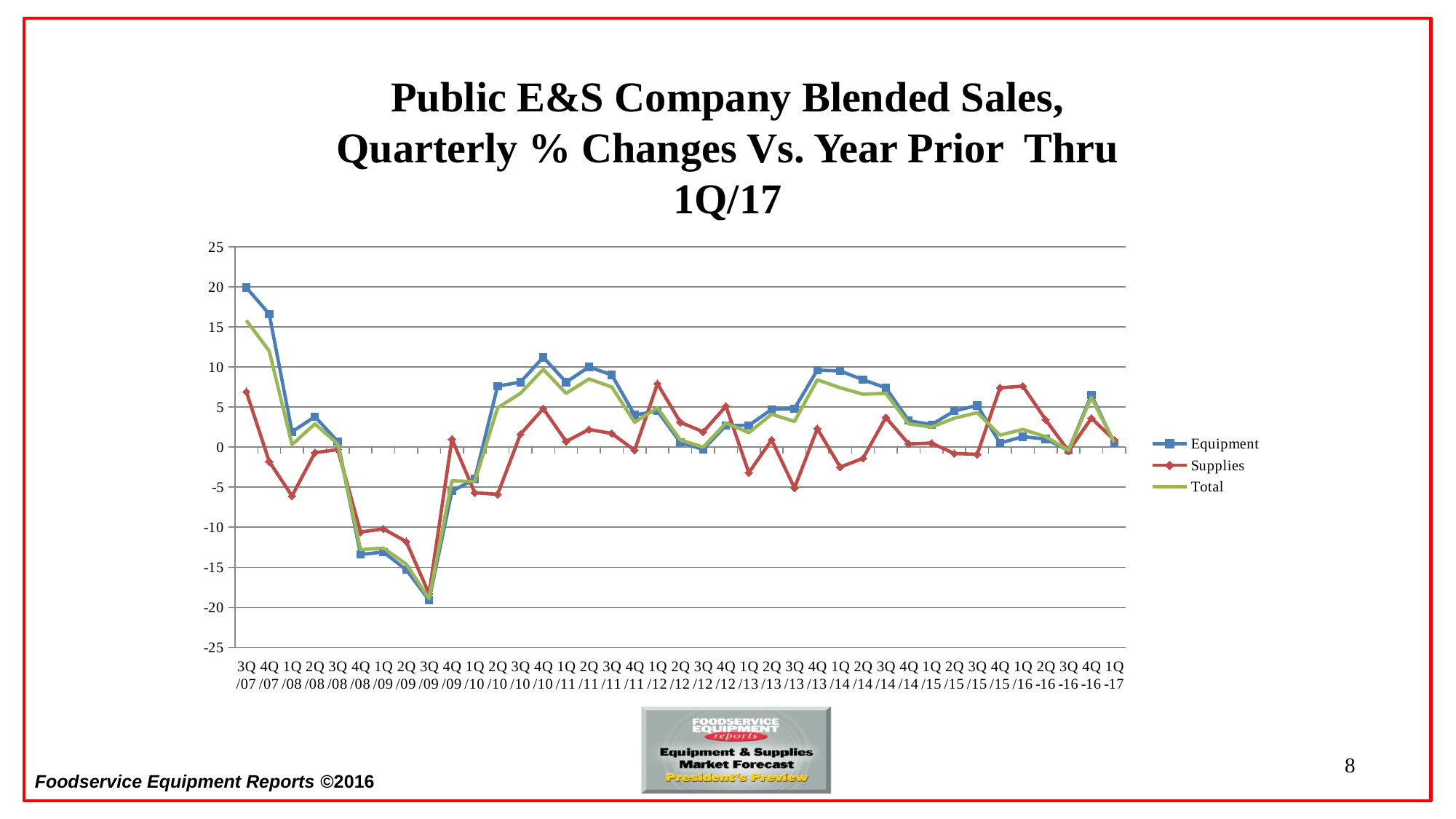
Does the Equipment series rise or fall from 3Q/07 to 3Q/09? fall How many series does the legend list? 3 Which series has the larger value at 1Q/16, Equipment or Supplies? Supplies Which series has the larger value at 3Q/07, Equipment or Supplies? Equipment In which quarter does the Equipment series reach its highest value? 3Q/07 Is the Equipment value for 3Q/09 greater or less than -15? less Is the Equipment value for 3Q/07 greater or less than 15? greater How many quarters are plotted along the x axis? 39 In which quarter does the Equipment series reach its lowest value? 3Q/09 What are the three series named in the legend? Equipment, Supplies, Total What kind of chart is shown on the slide? line chart Is the Supplies value for 1Q/16 greater or less than 5? greater